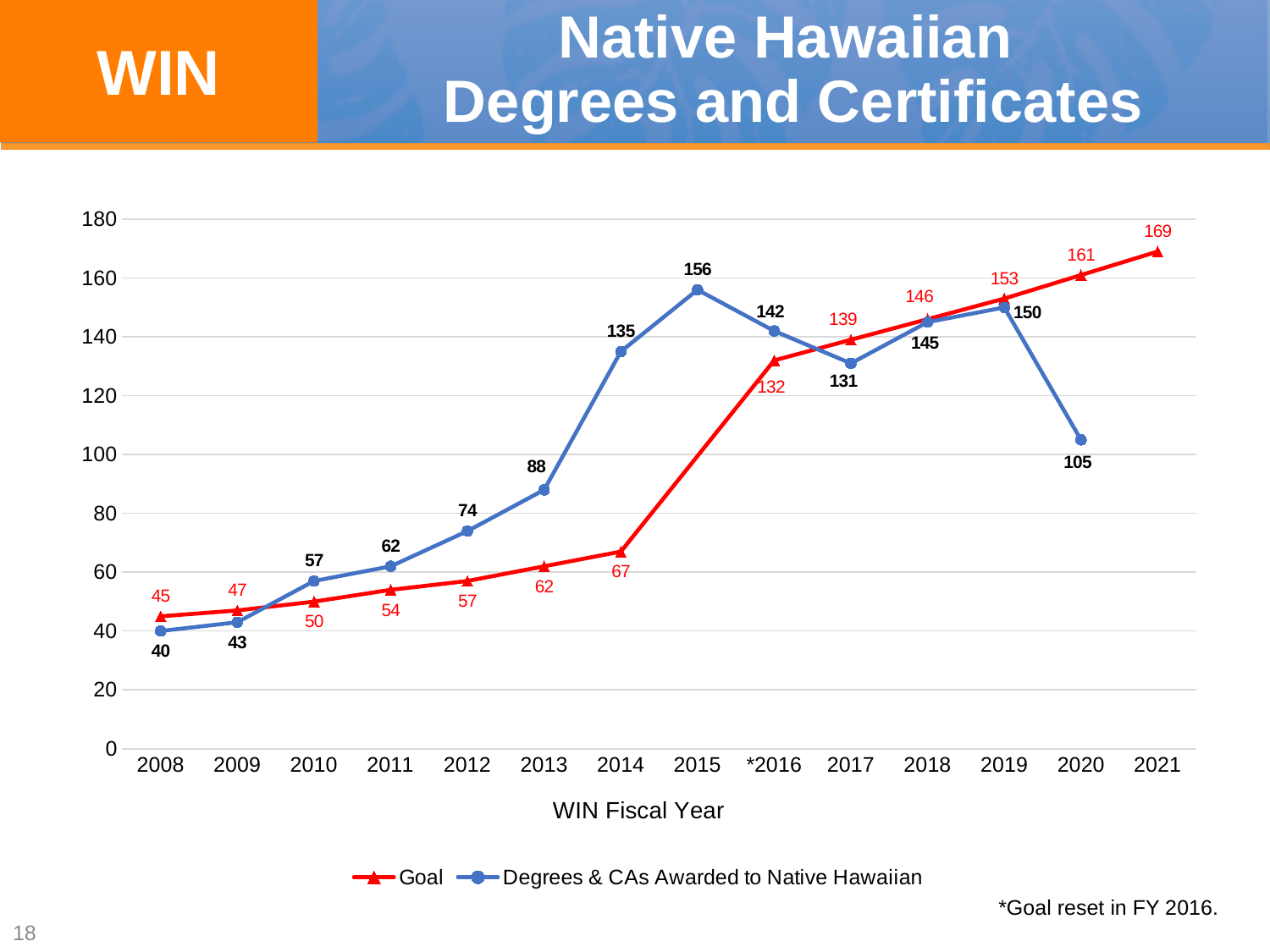
What is the difference between the Goal and the Degrees & CAs Awarded to Native Hawaiian in 2020? 56 In which year is the Degrees & CAs Awarded to Native Hawaiian series highest? 2015 What is the value of Degrees & CAs Awarded to Native Hawaiian in 2015? 156 What is the Goal value for 2021? 169 How many series does the legend list? 2 What is the label of the x axis? WIN Fiscal Year What kind of chart is shown on the slide? Line chart What is the value of Degrees & CAs Awarded to Native Hawaiian in 2020? 105 In 2014, which is larger: the Goal or the Degrees & CAs Awarded to Native Hawaiian? Degrees & CAs Awarded to Native Hawaiian Does the Goal series rise or fall from 2008 to 2021? Rise In 2017, which is larger: the Goal or the Degrees & CAs Awarded to Native Hawaiian? Goal In which year is the Degrees & CAs Awarded to Native Hawaiian series lowest? 2008